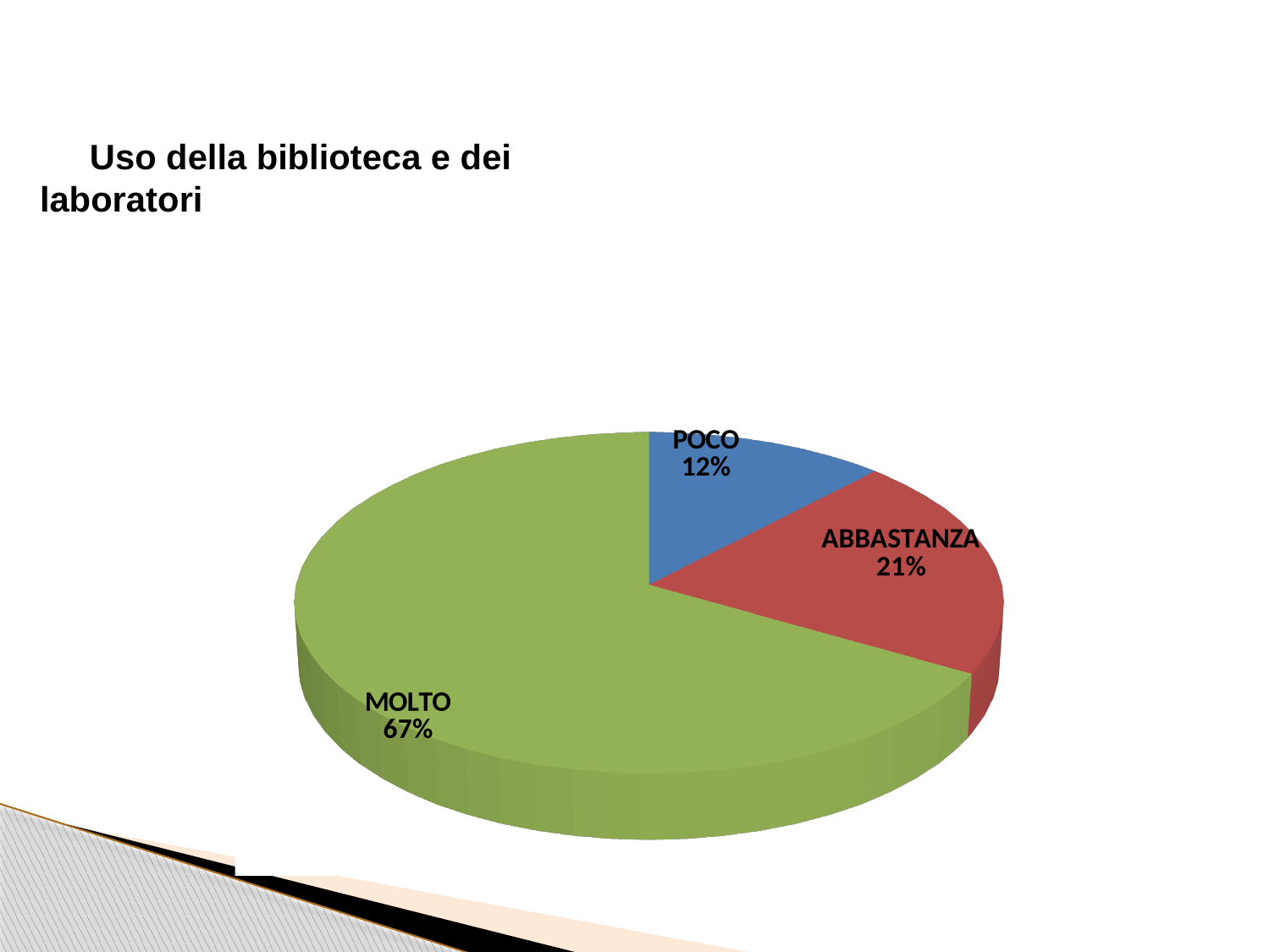
Which category has the largest slice of the pie? MOLTO Which is larger, the slice for ABBASTANZA or the slice for POCO? ABBASTANZA How many slices does the pie chart have? 3 What colour is the MOLTO slice of the pie? green What is the title of the slide containing the pie chart? Uso della biblioteca e dei laboratori Which category has the smallest slice of the pie? POCO What is the difference in percentage points between MOLTO and ABBASTANZA? 46 What is the difference in percentage points between ABBASTANZA and POCO? 9 What kind of chart is shown on the slide? pie chart What share of the pie does POCO represent? 12% What share of the pie does ABBASTANZA represent? 21% What share of the pie does MOLTO represent? 67%